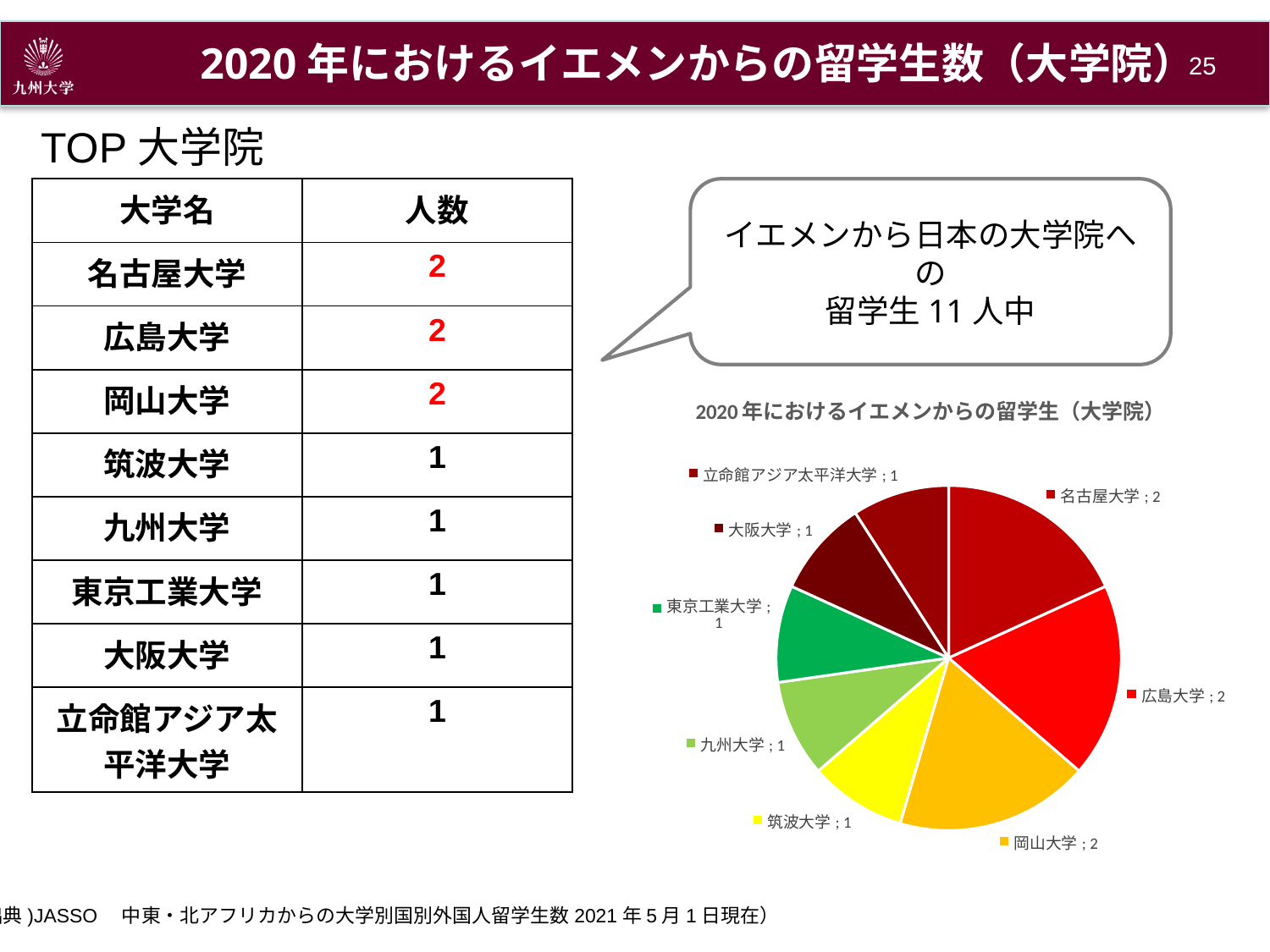
What is the total of all slices in the pie chart? 11 What is the title of the pie chart? 2020年におけるイエメンからの留学生（大学院） What is the value for 岡山大学 in the pie chart? 2 What is the difference between the values for 名古屋大学 and 九州大学 in the pie chart? 1 What is the value for 名古屋大学 in the pie chart? 2 What type of chart is shown on the slide? pie chart What is the value for 東京工業大学 in the pie chart? 1 How many universities in the pie chart have a value of 2? 3 How many slices does the pie chart have? 8 What is the value for 立命館アジア太平洋大学 in the pie chart? 1 What is the value for 筑波大学 in the pie chart? 1 Which is larger in the pie chart, 広島大学 or 大阪大学? 広島大学